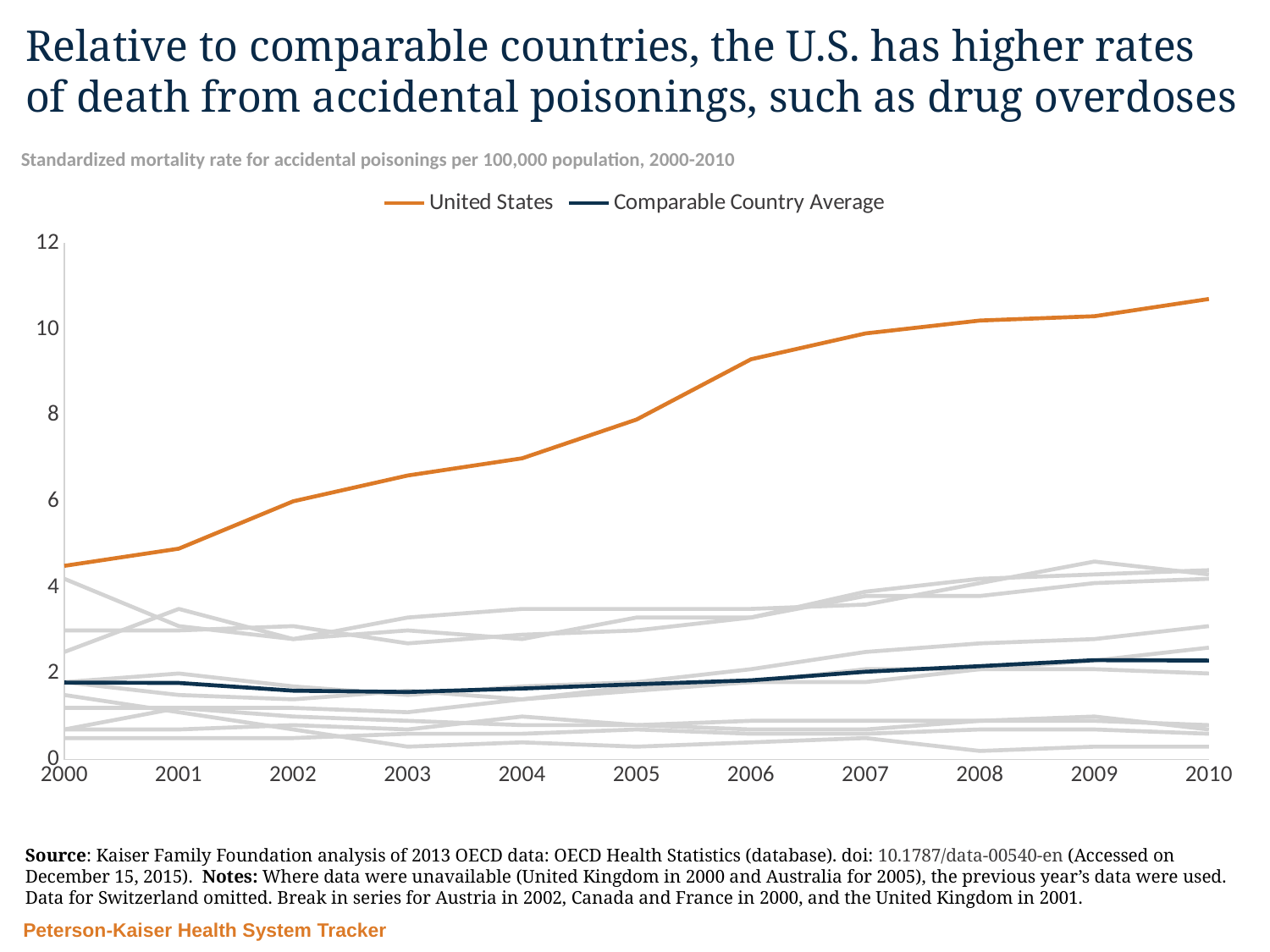
In 2010, which is larger: the United States value or the Comparable Country Average value? United States Is the Comparable Country Average value in 2003 greater or less than 2? less Is the United States value in 2000 greater or less than 4? greater In which year is the United States value highest? 2010 In which year is the United States value lowest? 2000 How many years are shown along the x axis? 11 How many series does the legend list? 2 What colour is the United States line? orange Is the United States value in 2006 greater or less than 8? greater Does the United States line rise or fall from 2000 to 2010? rises What kind of chart is shown on the slide? line chart